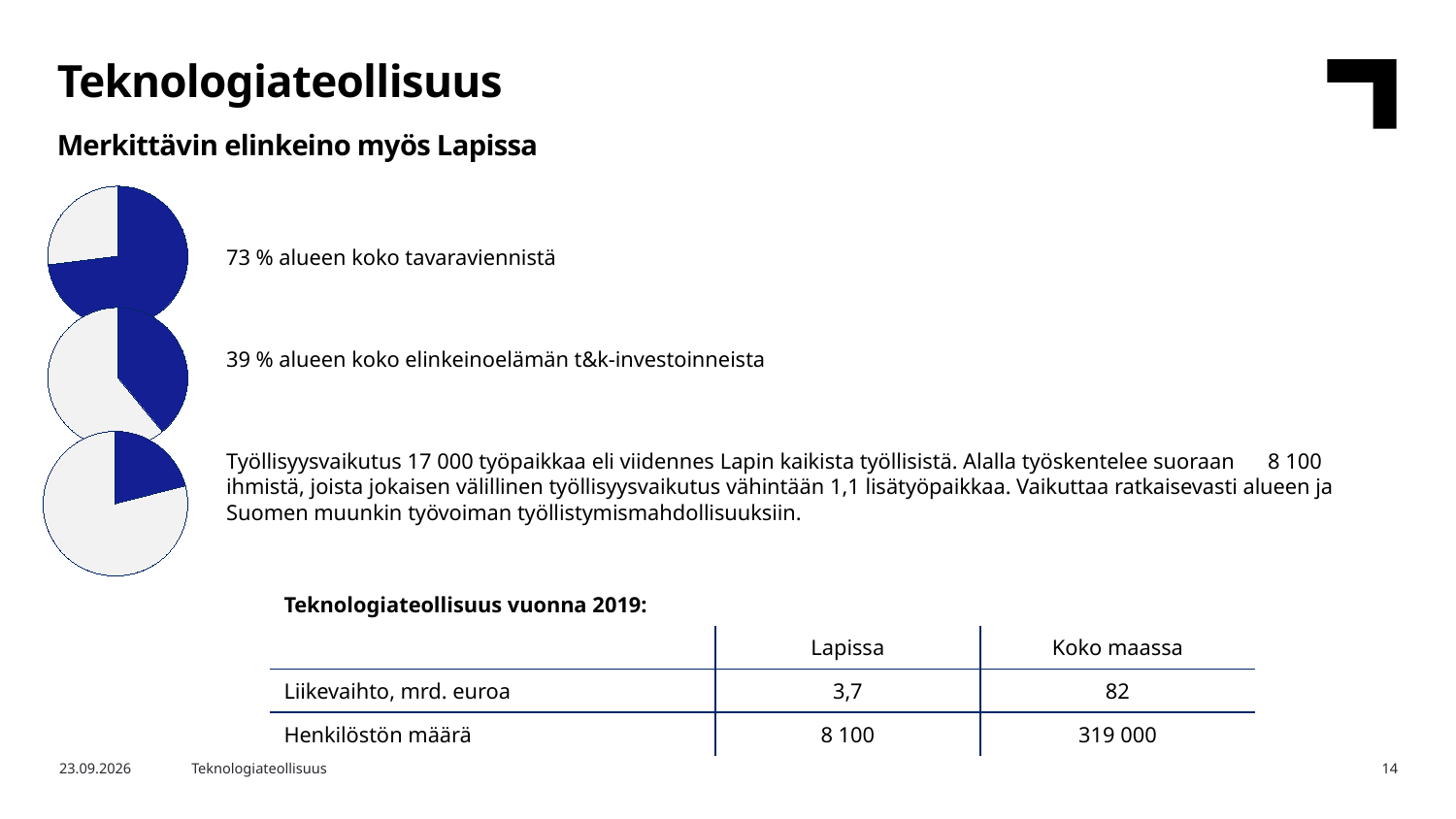
Is the blue share in the bottom pie chart greater or less than 50 %? less Which pie chart has the largest blue slice: the top, middle or bottom one? Top Is the blue share in the top pie chart greater or less than 50 %? greater Is the blue slice in the top pie chart larger or smaller than the blue slice in the middle pie chart? Larger In the top pie chart, what share of the region's total goods exports does the blue slice represent? 73 % What kind of charts are shown on the left side of the slide? Pie charts In the middle pie chart, what share of the region's business R&D investments does the blue slice represent? 39 % What is the difference between the blue shares of the top and middle pie charts? 34 % Is the blue slice in the bottom pie chart larger or smaller than the blue slice in the middle pie chart? Smaller What colour is used for the highlighted slice in each pie chart? Blue Which pie chart has the smallest blue slice: the top, middle or bottom one? Bottom How many pie charts are on the slide? 3